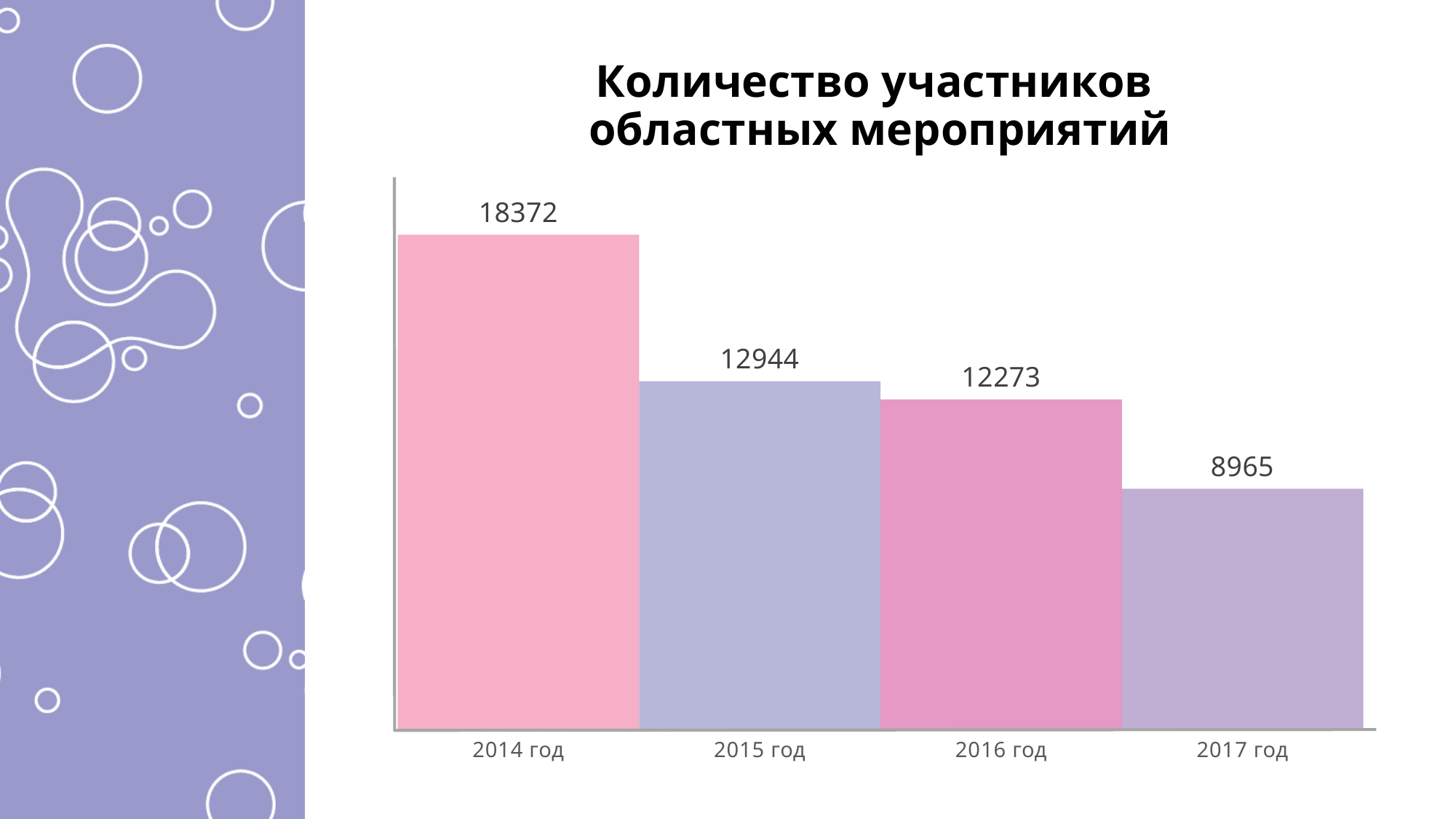
Which year has the lowest number of participants? 2017 год What is the value for 2015 год? 12944 What kind of chart is shown on the slide? bar chart What is the value for 2016 год? 12273 How many categories are shown in the chart? 4 Do the values rise or fall from 2014 год to 2017 год? fall What is the value for 2017 год? 8965 Which is larger, the value for 2015 год or the value for 2016 год? 2015 год What is the difference between the values for 2015 год and 2016 год? 671 What is the difference between the values for 2014 год and 2017 год? 9407 Which year has the highest number of participants? 2014 год What is the value for 2014 год? 18372